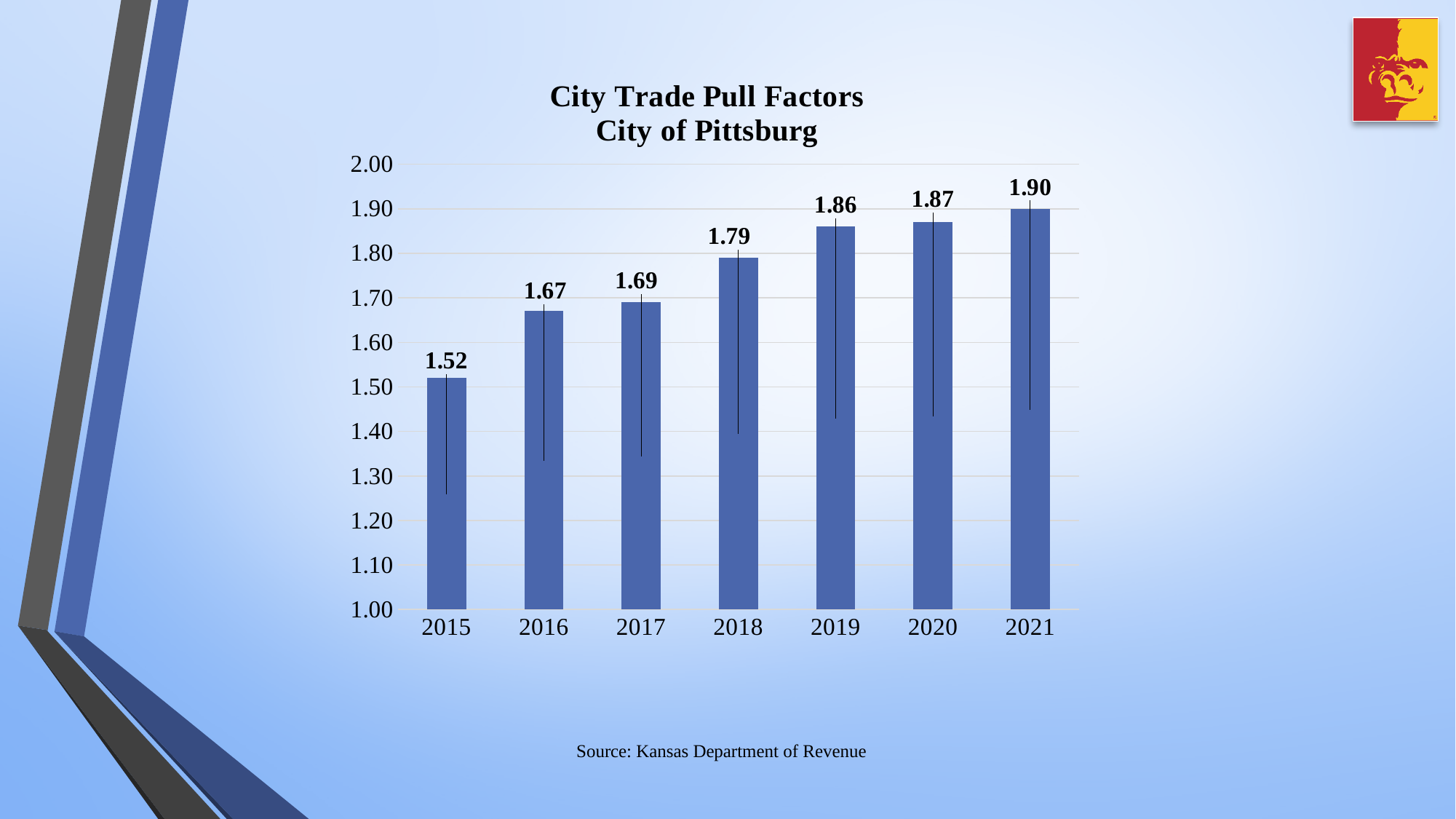
What is the difference between the trade pull factors for 2019 and 2018? 0.07 What is the trade pull factor for 2021? 1.90 What is the trade pull factor for 2015? 1.52 Which year has the highest trade pull factor? 2021 How many years are shown on the chart? 7 Which year has a larger trade pull factor, 2016 or 2019? 2019 What kind of chart is shown on the slide? Bar chart Do the trade pull factors rise or fall from 2015 to 2021? Rise What is the title of the chart? City Trade Pull Factors City of Pittsburg What is the trade pull factor for 2018? 1.79 What is the difference between the trade pull factors for 2021 and 2015? 0.38 Which year has the lowest trade pull factor? 2015